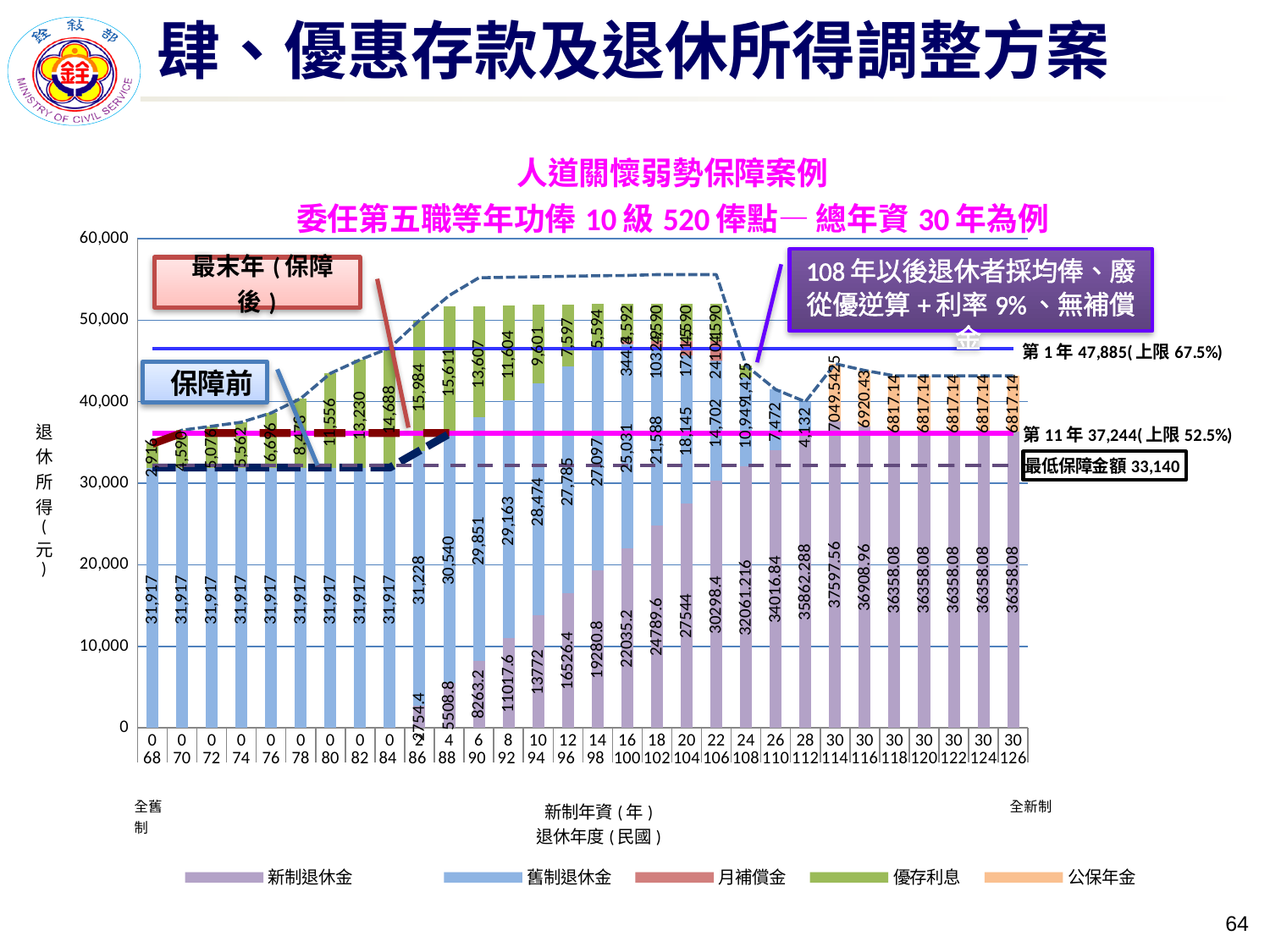
What value is labelled for the 最低保障金額 reference line? 33,140 Does the 新制退休金 value rise or fall from category 2/86 to category 22/106? rise Which is larger, the 舊制退休金 value for 6/90 or for 20/104? 6/90 How many series does the legend list? 5 What is the value of 新制退休金 for the category 30/126? 36358.08 What is the value of 公保年金 for the category 30/116? 6920.43 What is the difference between the 舊制退休金 values for 2/86 and 4/88? 688 What is the value of 優存利息 for the category 2/86? 15,984 What is the value of 舊制退休金 for the category 28/112? 4,132 What kind of chart is shown on the slide? combination stacked bar and line chart What is the value of 新制退休金 for the category 10/94? 13772 What is the value of 舊制退休金 for the category 0/68? 31,917